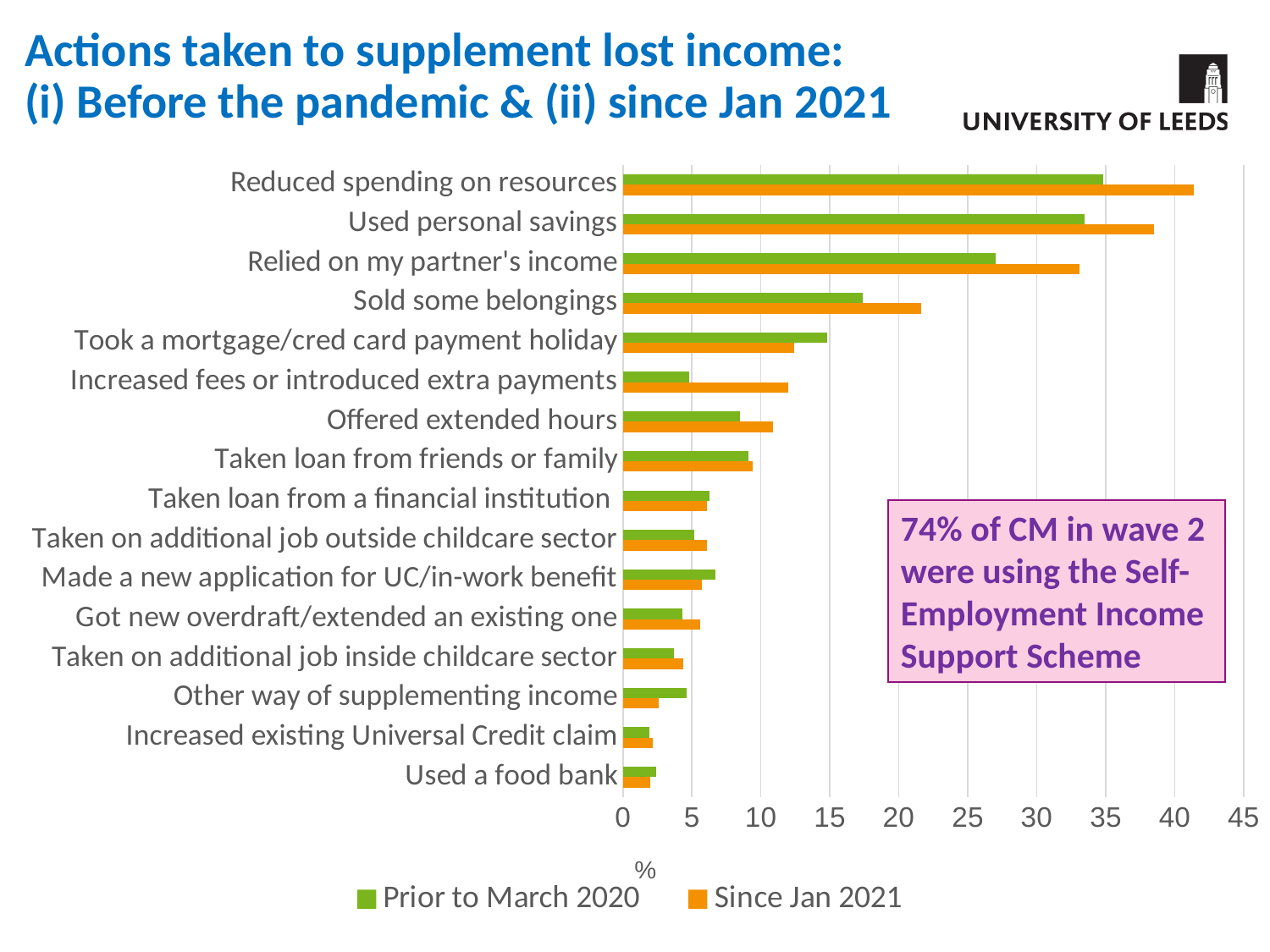
Is the Since Jan 2021 value for Reduced spending on resources greater or less than 40? greater Is the Prior to March 2020 value for Sold some belongings greater or less than 20? less Is the Prior to March 2020 value for Used personal savings greater or less than 30? greater For Took a mortgage/cred card payment holiday, which series has the larger value: Prior to March 2020 or Since Jan 2021? Prior to March 2020 How many categories (actions) are plotted on the chart? 16 For Relied on my partner's income, which series has the larger value: Prior to March 2020 or Since Jan 2021? Since Jan 2021 Which action has the highest value for the Since Jan 2021 series? Reduced spending on resources What are the two series names listed in the legend? Prior to March 2020 and Since Jan 2021 Which action has the highest value for the Prior to March 2020 series? Reduced spending on resources How many series does the legend list? 2 What kind of chart is shown on the slide? bar chart